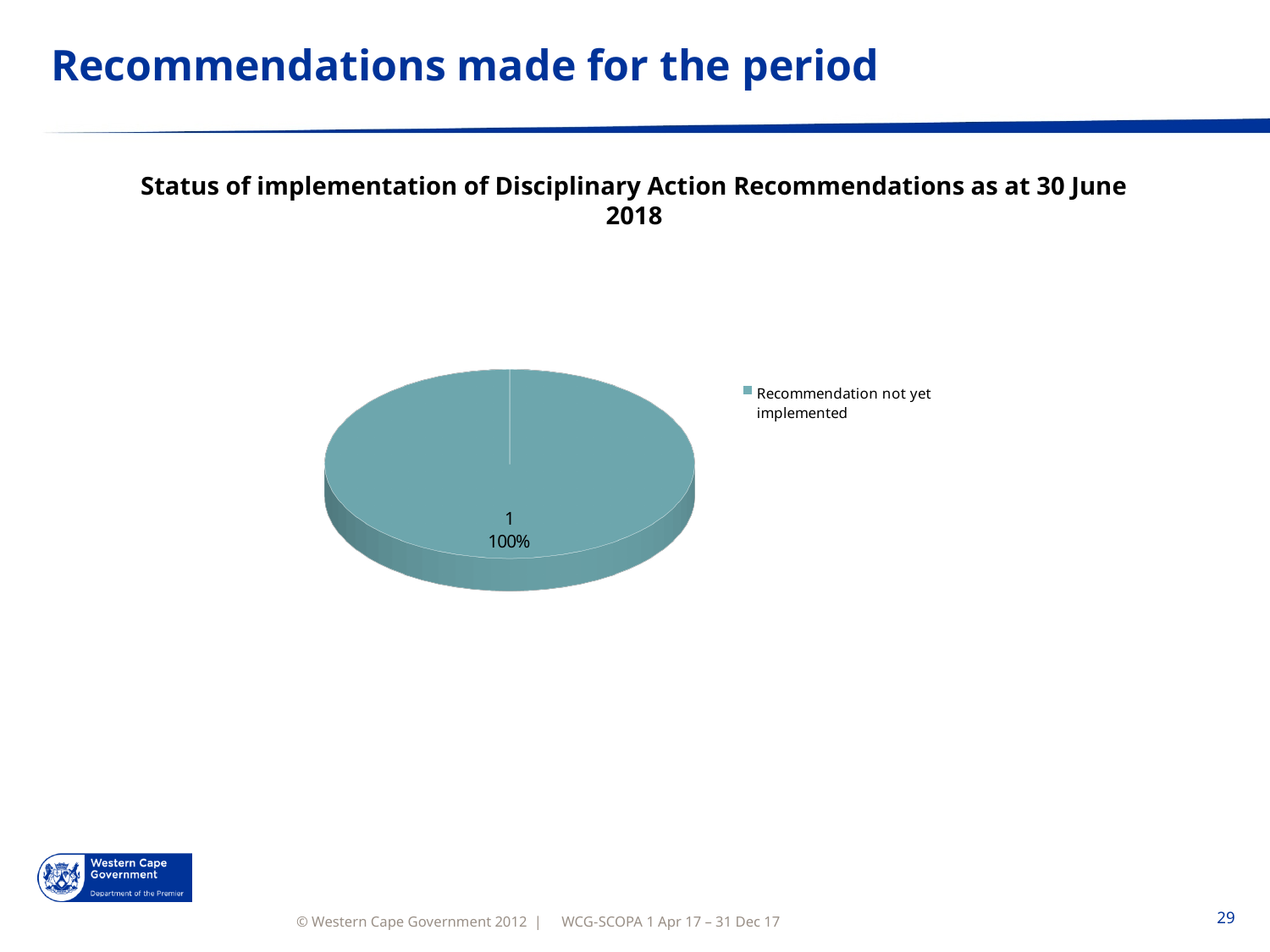
What kind of chart is shown on the slide? pie chart What is the title of the chart? Status of implementation of Disciplinary Action Recommendations as at 30 June 2018 Which category makes up the largest share of the pie? Recommendation not yet implemented How many slices does the pie chart have? 1 What is the value shown for "Recommendation not yet implemented"? 1 What is the label of the only legend entry? Recommendation not yet implemented What share of the pie does "Recommendation not yet implemented" represent? 100% How many entries does the legend list? 1